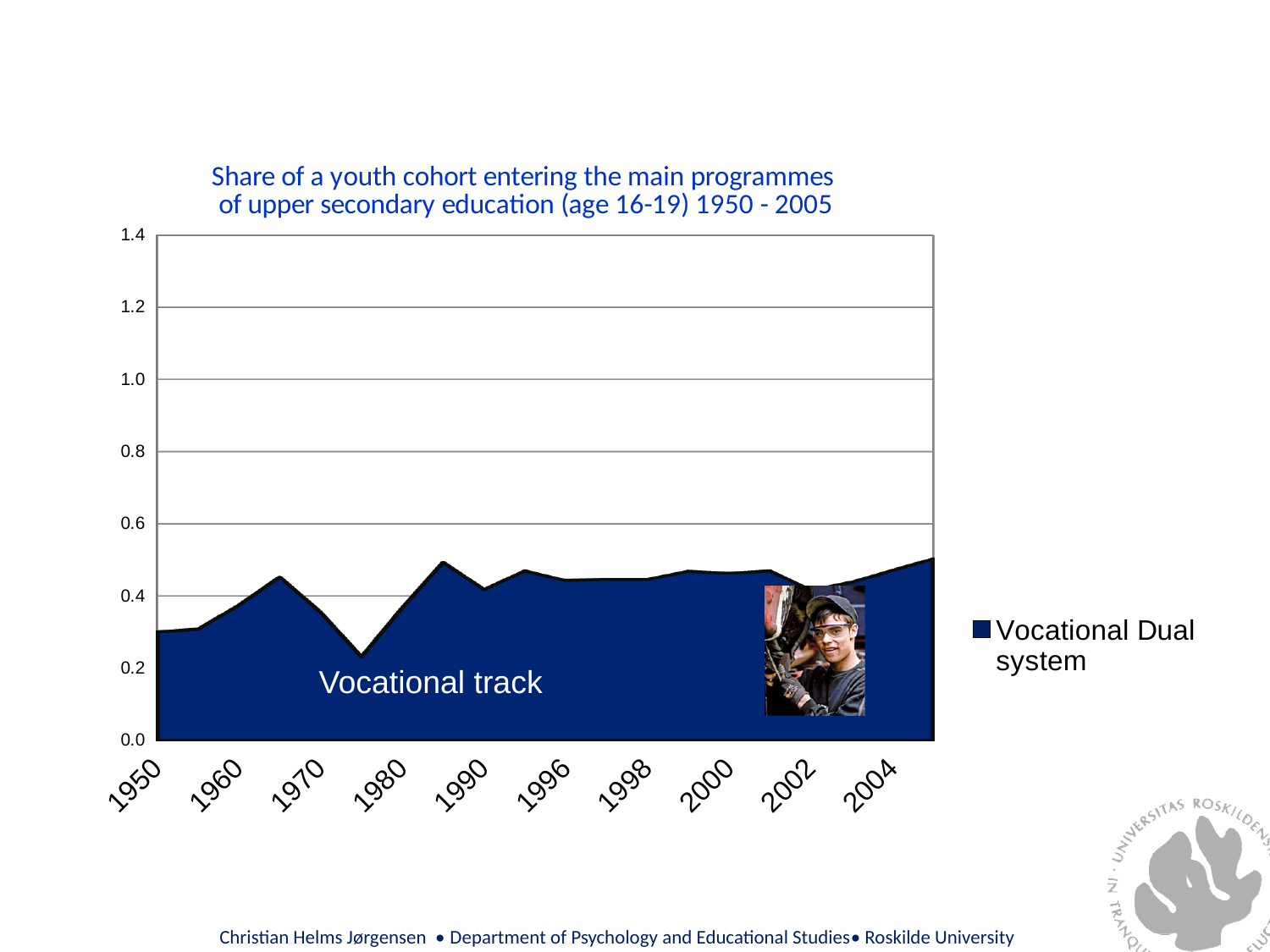
Is the value for 1950 greater or less than 0.4? less Which is larger, the value for 1950 or the value for 2004? 2004 Is the value for 2000 greater or less than 0.4? greater What kind of chart is shown on the slide? area chart What is the name of the series shown in the legend? Vocational Dual system What is the title of the chart? Share of a youth cohort entering the main programmes of upper secondary education (age 16-19) 1950 - 2005 How many series does the legend list? 1 Is the value for 1960 greater or less than 0.4? less Which is larger, the value for 1960 or the value for 1996? 1996 Overall, does the value rise or fall from 1950 to 2004? rise